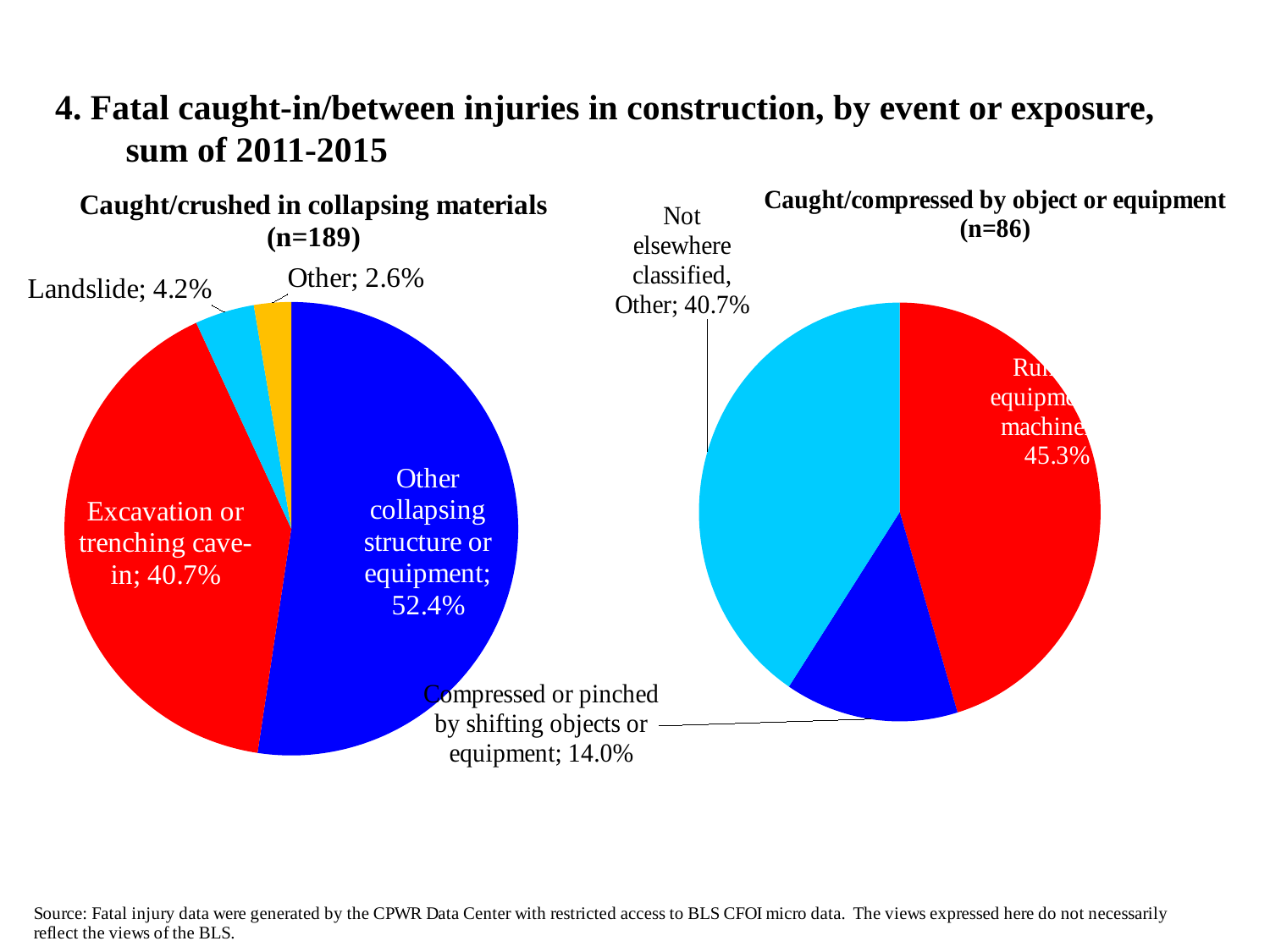
In the 'Caught/crushed in collapsing materials' chart, what share is 'Other collapsing structure or equipment'? 52.4% In the 'Caught/crushed in collapsing materials' chart, what share is 'Landslide'? 4.2% In the 'Caught/crushed in collapsing materials' chart, how many slices are there? 4 What is the sample size (n) given in the title of the 'Caught/compressed by object or equipment' chart? 86 In the 'Caught/crushed in collapsing materials' chart, which category has the largest share? Other collapsing structure or equipment What type of charts are shown on the slide? Pie charts In the 'Caught/compressed by object or equipment' chart, what share is 'Not elsewhere classified, Other'? 40.7% In the 'Caught/compressed by object or equipment' chart, what share is 'Compressed or pinched by shifting objects or equipment'? 14.0% In the 'Caught/crushed in collapsing materials' chart, what share is 'Excavation or trenching cave-in'? 40.7% In the 'Caught/crushed in collapsing materials' chart, what is the difference in percentage points between 'Other collapsing structure or equipment' and 'Excavation or trenching cave-in'? 11.7 In the 'Caught/crushed in collapsing materials' chart, which category has the smallest share? Other In the 'Caught/compressed by object or equipment' chart, what is the percentage of the largest slice? 45.3%